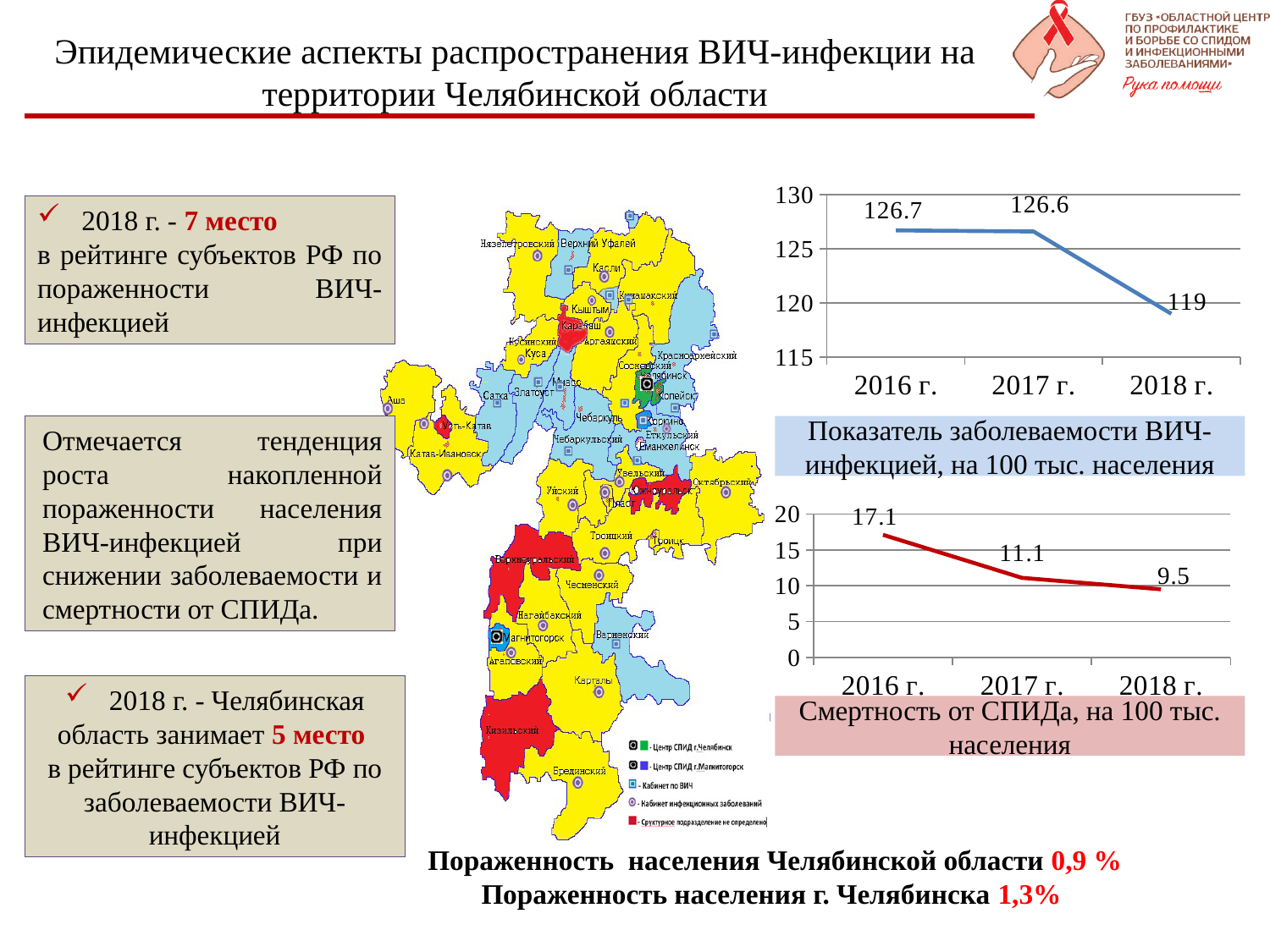
In the top chart (Показатель заболеваемости ВИЧ-инфекцией), what is the difference between the 2017 г. and 2018 г. values? 7.6 What kind of chart is the top chart (Показатель заболеваемости ВИЧ-инфекцией)? Line chart In the top chart (Показатель заболеваемости ВИЧ-инфекцией), what is the value for 2018 г.? 119 In the bottom chart (Смертность от СПИДа), what is the difference between the 2016 г. and 2018 г. values? 7.6 In the top chart (Показатель заболеваемости ВИЧ-инфекцией, на 100 тыс. населения), what is the value for 2016 г.? 126.7 In the bottom chart (Смертность от СПИДа), which year has the highest value? 2016 г. In the top chart (Показатель заболеваемости ВИЧ-инфекцией), how many data points are plotted? 3 In the bottom chart (Смертность от СПИДа), do the values rise or fall from 2016 г. to 2018 г.? Fall In the bottom chart (Смертность от СПИДа), is the value for 2018 г. greater or less than 10? less In the bottom chart (Смертность от СПИДа), what is the value for 2017 г.? 11.1 In the bottom chart (Смертность от СПИДа, на 100 тыс. населения), what is the value for 2016 г.? 17.1 In the top chart (Показатель заболеваемости ВИЧ-инфекцией), which year has the lowest value? 2018 г.